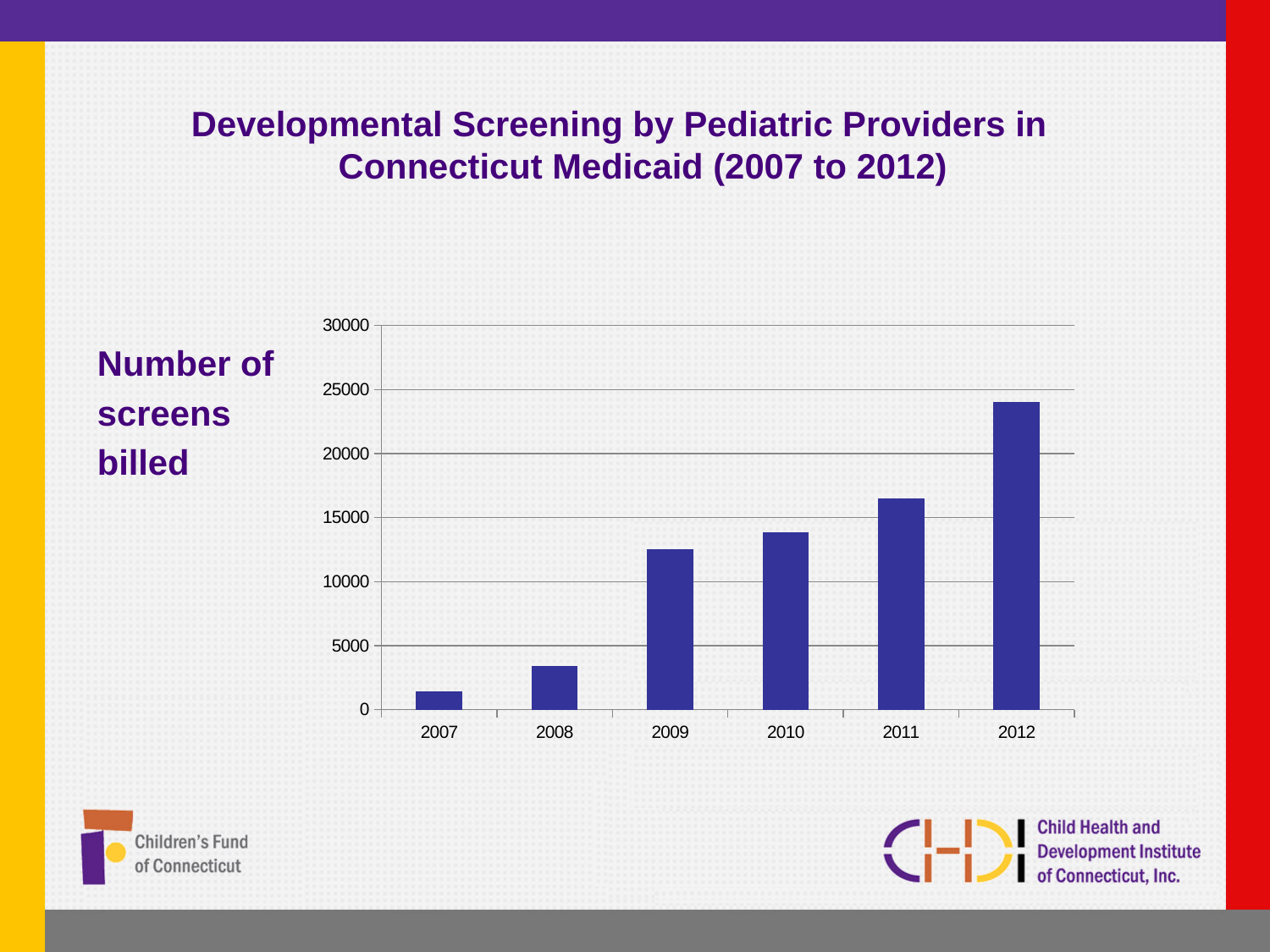
Which year has more screens billed, 2011 or 2009? 2011 What kind of chart is shown on the slide? bar chart What is the title of the chart on the slide? Developmental Screening by Pediatric Providers in Connecticut Medicaid (2007 to 2012) Is the value for 2009 greater or less than 10000? greater Is the value for 2007 greater or less than 5000? less Which year has the lowest number of screens billed? 2007 Which year has the highest number of screens billed? 2012 Is the value for 2012 greater or less than 20000? greater How many years are plotted on the x axis of the chart? 6 Do the number of screens billed rise or fall from 2007 to 2012? rise Which year has more screens billed, 2008 or 2007? 2008